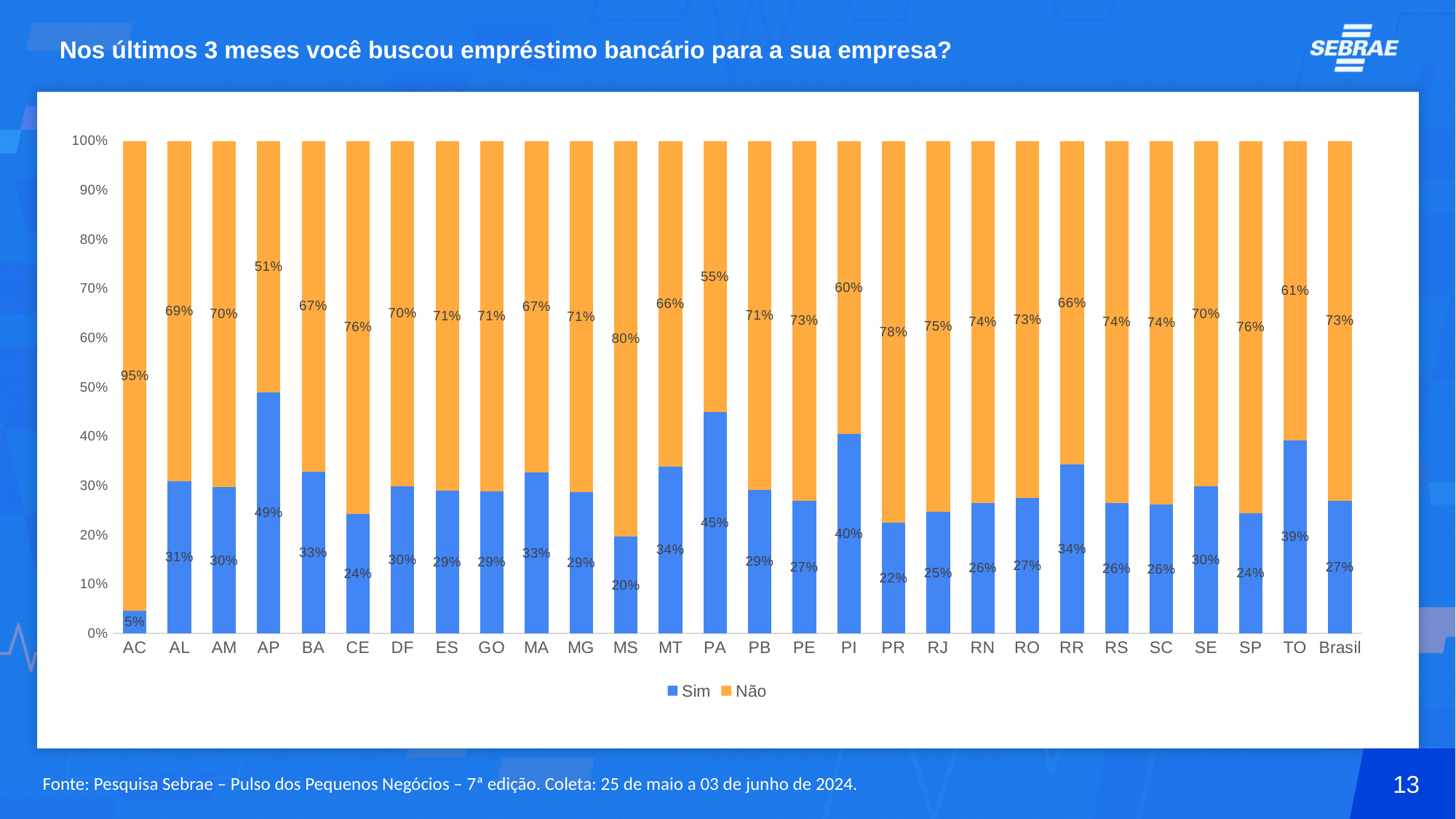
What kind of chart is shown on the slide? Stacked bar chart Which is larger, the "Sim" value for MT or the "Sim" value for MS? MT Which category has the lowest "Sim" value? AC What is the "Não" value for MS? 80% Which category has the highest "Não" value? AC What is the "Sim" value for Brasil? 27% How many series does the legend list? 2 Which colour represents the "Não" series? Orange What is the difference between the "Sim" values for PA and TO? 6% Which category has the highest "Sim" value? AP How many categories are shown on the x axis? 28 What is the "Sim" value for PI? 40%